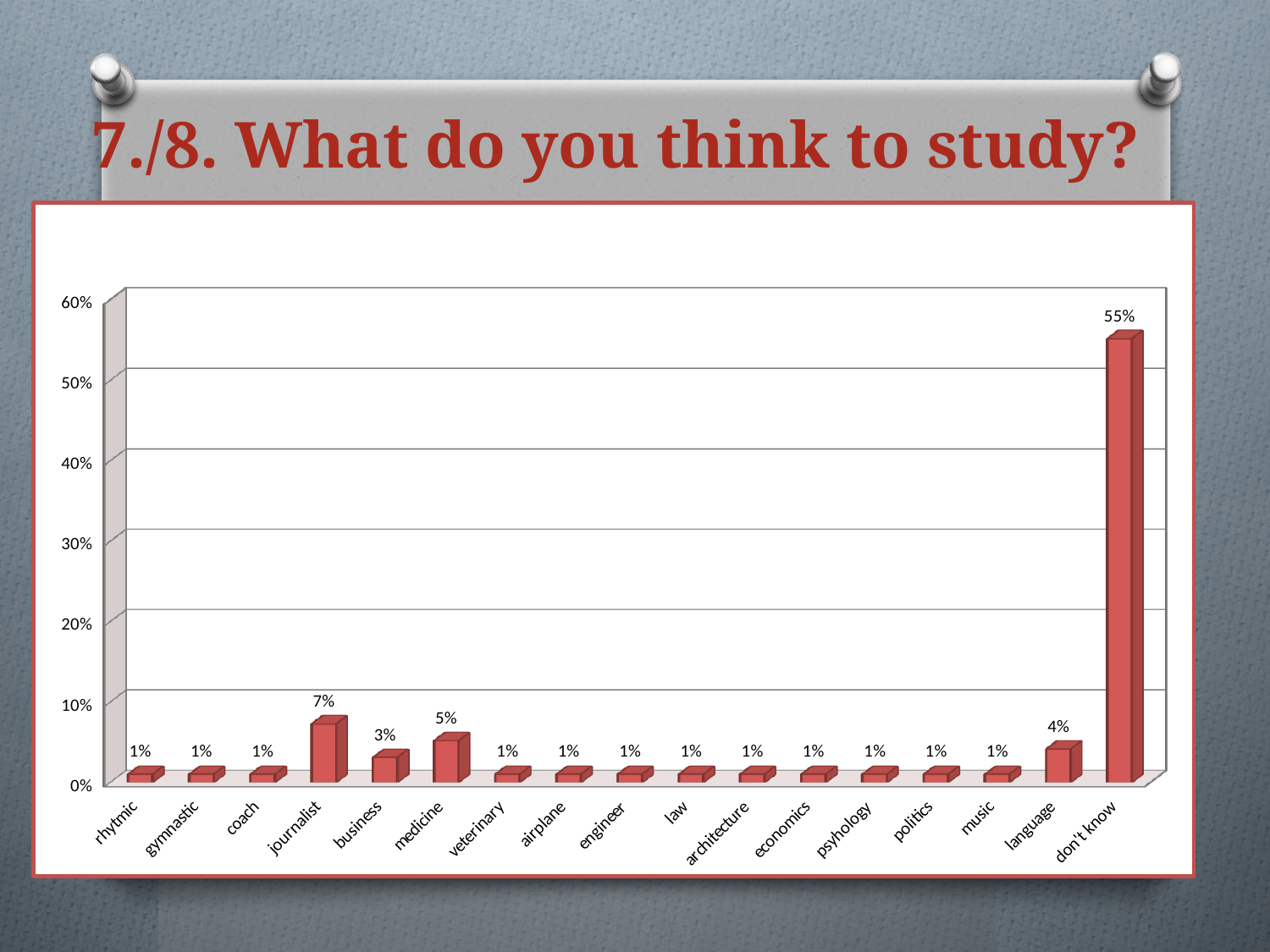
Is the value for "don't know" greater or less than 50%? greater What is the difference between the values for journalist and medicine? 2% What is the value for business? 3% What percentage of respondents answered "don't know"? 55% How many categories are shown on the x axis? 17 What is the value for medicine? 5% What is the difference between the values for "don't know" and language? 51% What is the value for language? 4% What kind of chart is shown on the slide? bar chart Which category has the highest value? don't know Which is larger, the value for business or the value for language? language What is the value for journalist? 7%